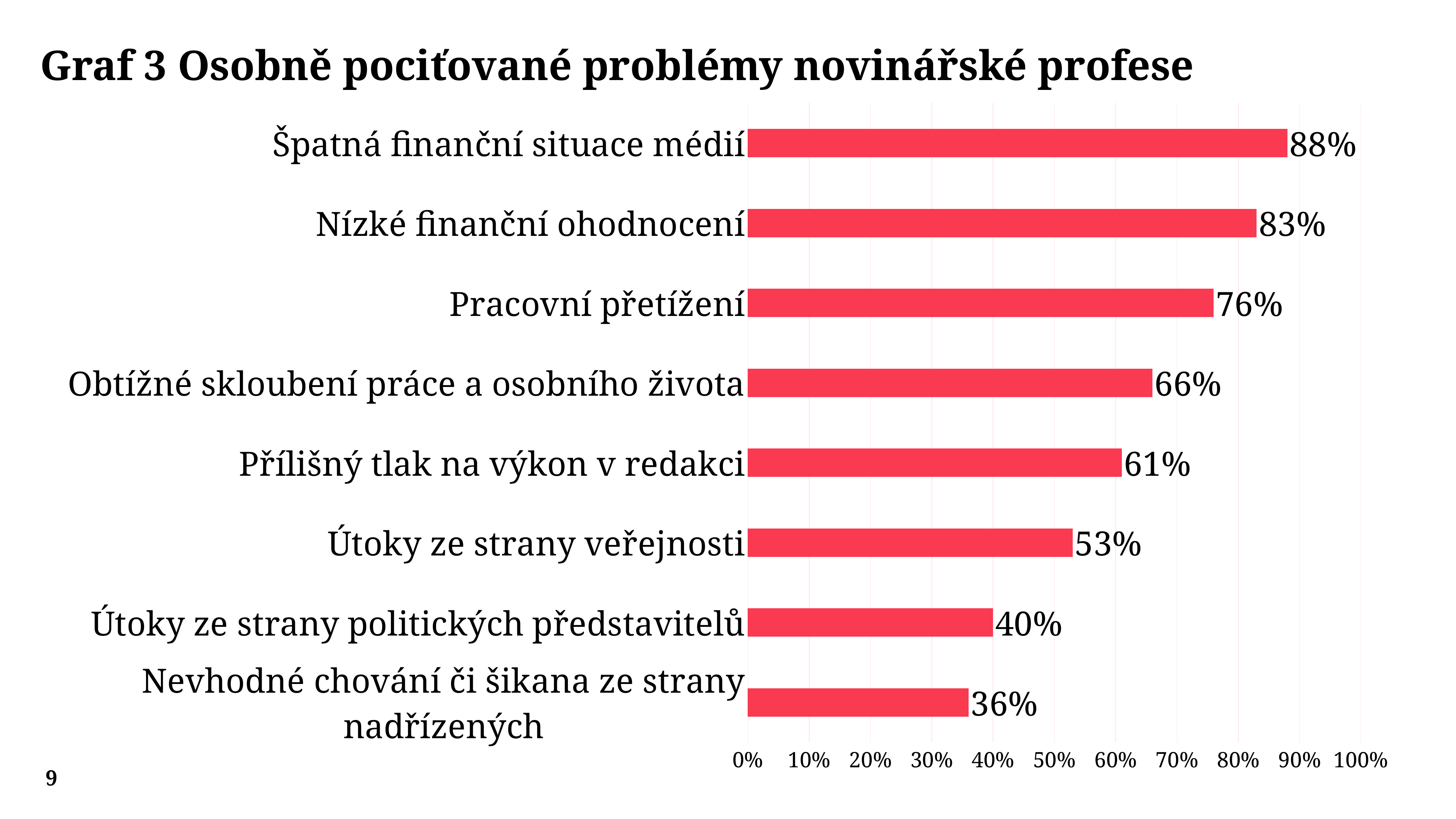
What is the value for Pracovní přetížení? 76% What is the value for Útoky ze strany politických představitelů? 40% Which category has the lowest value? Nevhodné chování či šikana ze strany nadřízených What kind of chart is shown on the slide? bar chart Which category has the highest value? Špatná finanční situace médií How many categories are shown in the chart? 8 What is the difference between the values for Nízké finanční ohodnocení and Útoky ze strany veřejnosti? 30% What is the title of the chart? Graf 3 Osobně pociťované problémy novinářské profese What is the value for Špatná finanční situace médií? 88% What is the difference between the values for Špatná finanční situace médií and Nevhodné chování či šikana ze strany nadřízených? 52% Which is larger, the value for Obtížné skloubení práce a osobního života or the value for Přílišný tlak na výkon v redakci? Obtížné skloubení práce a osobního života Is the value for Útoky ze strany veřejnosti greater or less than 50%? greater